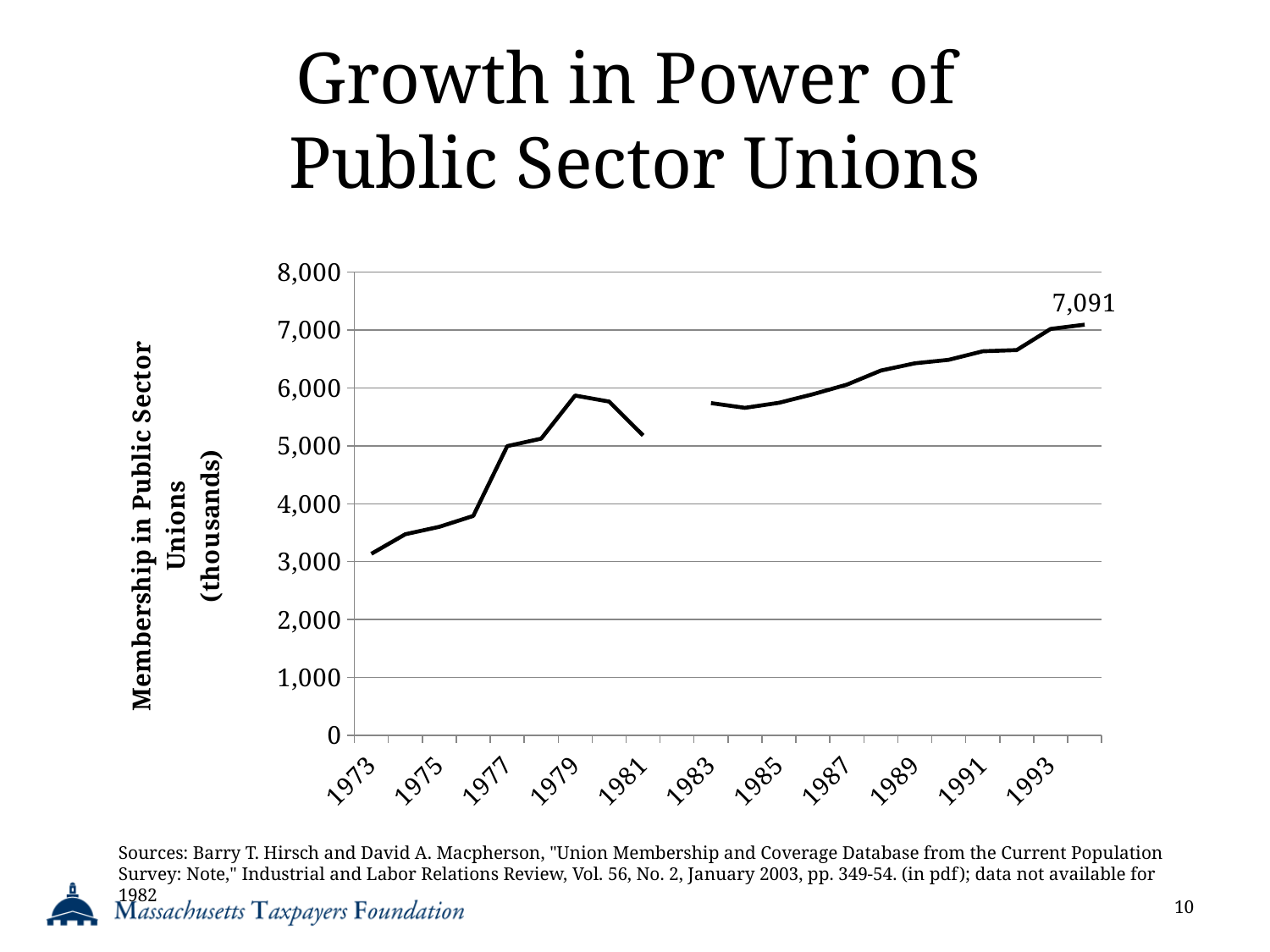
Is the value for 1991 greater or less than 6,000? greater Is the value for 1981 greater or less than 6,000? less Which year has the lowest membership value on the chart? 1973 What value is printed as the data label at the end of the line? 7,091 Is the value for 1973 greater or less than 3,000? greater Overall, do the values rise or fall from 1973 to the end of the series? rise Which is larger, the value for 1979 or the value for 1981? 1979 What kind of chart is shown on the slide? line chart What is the title of the vertical axis? Membership in Public Sector Unions (thousands) What is the highest value shown on the vertical axis? 8,000